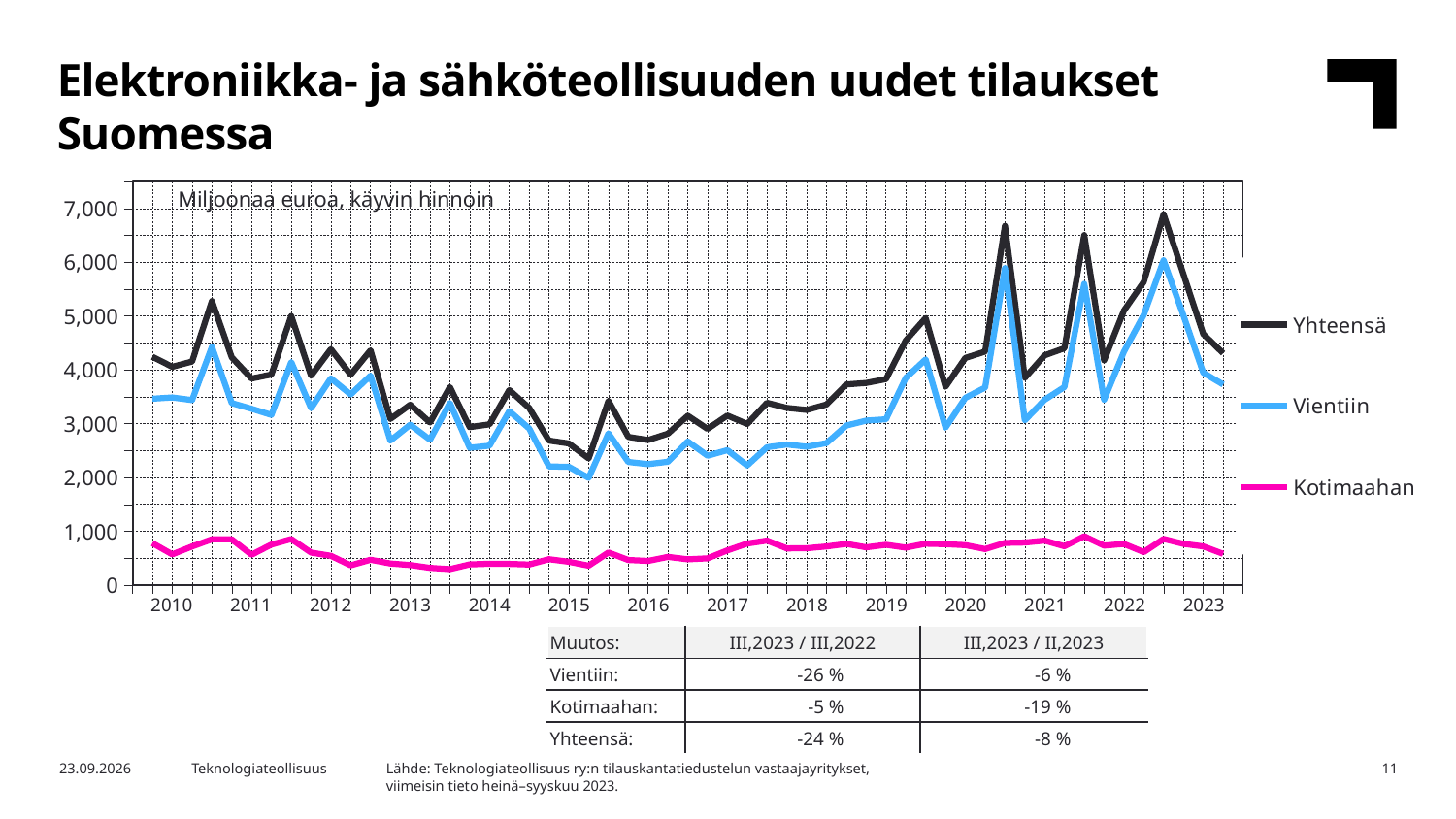
Which series has the highest values throughout the chart? Yhteensä Is the lowest value for Vientiin in 2015 greater or less than 3,000? less Is the peak value for Yhteensä in 2022 greater or less than 6,000? greater How many year labels are shown on the x axis? 14 Which series is larger across the whole period, Vientiin or Kotimaahan? Vientiin What kind of chart is shown on the slide? line chart What unit label is printed inside the chart area? Miljoonaa euroa, käyvin hinnoin What are the three series named in the chart's legend? Yhteensä, Vientiin, Kotimaahan Does the Yhteensä series generally rise or fall between 2010 and 2015? fall Is the value for Kotimaahan in 2023 greater or less than 1,000? less How many series does the chart's legend list? 3 Which series has the lowest values throughout the chart? Kotimaahan